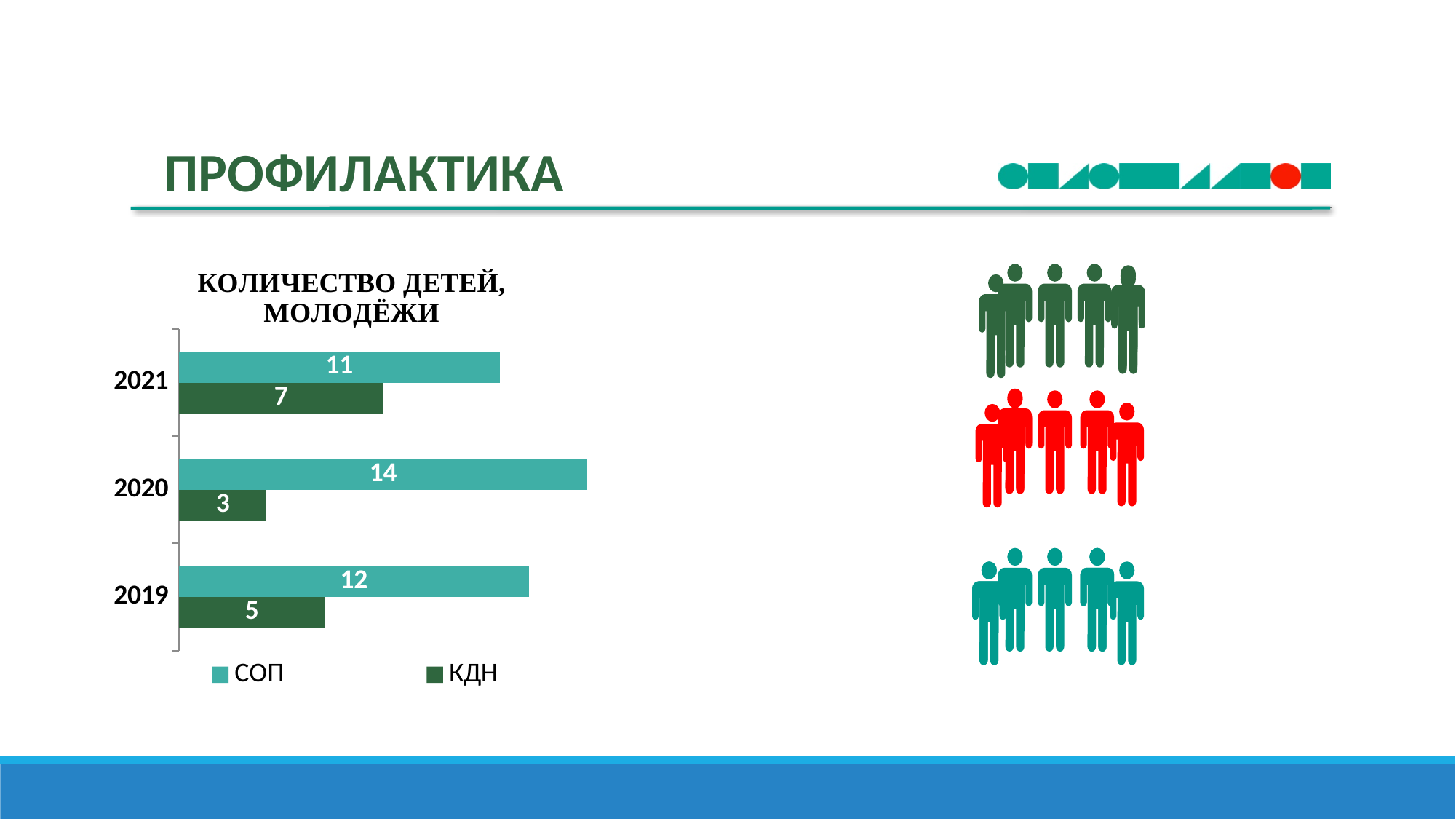
What is the value for СОП in 2020? 14 In which year is the СОП value highest? 2020 In which year is the КДН value lowest? 2020 Which is larger in 2020, the СОП value or the КДН value? СОП What is the title of the chart? КОЛИЧЕСТВО ДЕТЕЙ, МОЛОДЁЖИ What is the value for КДН in 2019? 5 How many years are shown on the chart? 3 How many series does the legend list? 2 What is the value for КДН in 2021? 7 What is the difference between the СОП and КДН values in 2021? 4 What is the value for СОП in 2019? 12 What kind of chart is shown on the slide? Bar chart